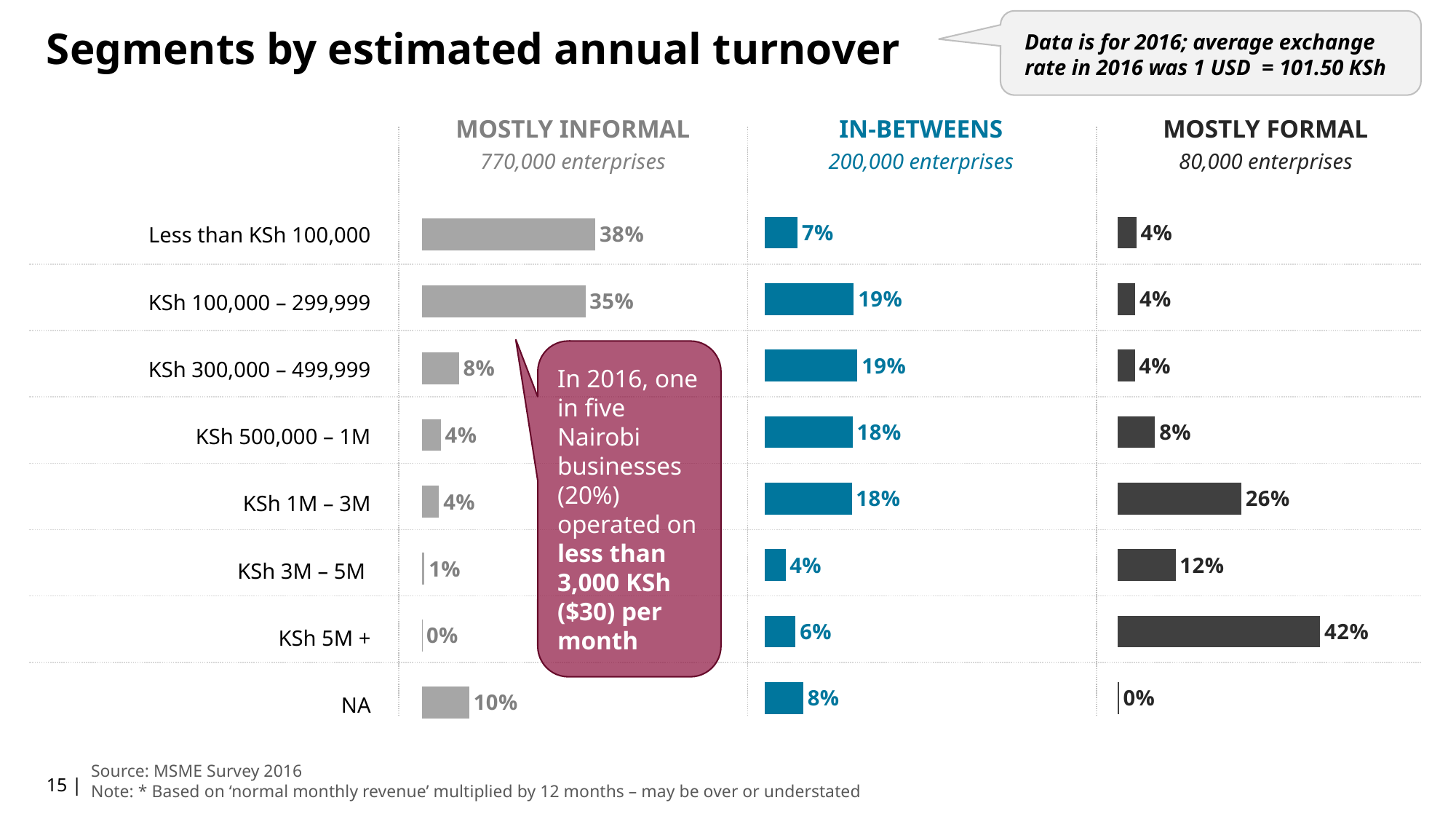
In the In-Betweens chart, which is larger: the value for KSh 100,000 – 299,999 or the value for KSh 3M – 5M? KSh 100,000 – 299,999 In the Mostly Formal chart, what is the difference between the KSh 5M + value and the KSh 1M – 3M value? 16% In the Mostly Informal chart, what is the difference between the values for Less than KSh 100,000 and KSh 100,000 – 299,999? 3% In the Mostly Informal chart, what percentage of enterprises have turnover of less than KSh 100,000? 38% How many enterprises are in the In-Betweens segment according to the chart heading? 200,000 enterprises In the Mostly Formal chart, what percentage of enterprises have turnover of KSh 5M +? 42% How many turnover categories are shown in each chart? 8 In the Mostly Formal chart, which turnover category has the highest value? KSh 5M + In the Mostly Informal chart, what is the value for the NA category? 10% In the In-Betweens chart, what is the value for KSh 500,000 – 1M? 18% In the Mostly Informal chart, which turnover category has the lowest value? KSh 5M + What type of chart is used to show the segments by estimated annual turnover? Bar chart